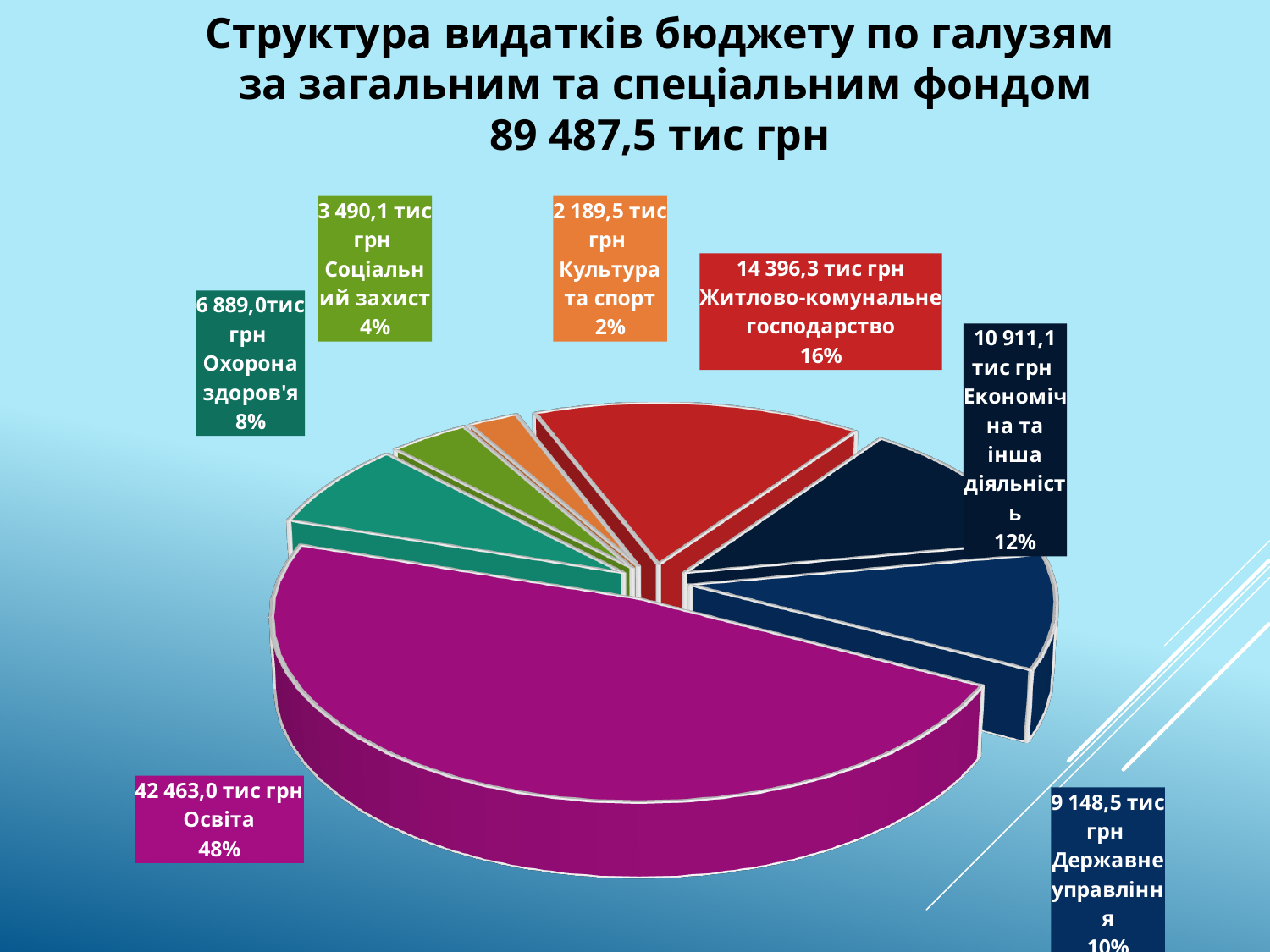
What kind of chart is shown on the slide? pie chart What is the value for Освіта? 42 463,0 тис грн Which is larger, Економічна та інша діяльність or Державне управління? Економічна та інша діяльність How many categories (slices) does the pie chart show? 7 Which category has the largest slice of the pie? Освіта What is the value for Соціальний захист? 3 490,1 тис грн What share of the pie does Культура та спорт represent? 2% What is the difference in percentage share between Житлово-комунальне господарство and Охорона здоров'я? 8% What is the value for Житлово-комунальне господарство? 14 396,3 тис грн Which category has the smallest slice of the pie? Культура та спорт What total amount is stated in the chart title? 89 487,5 тис грн What share of the pie does Освіта represent? 48%